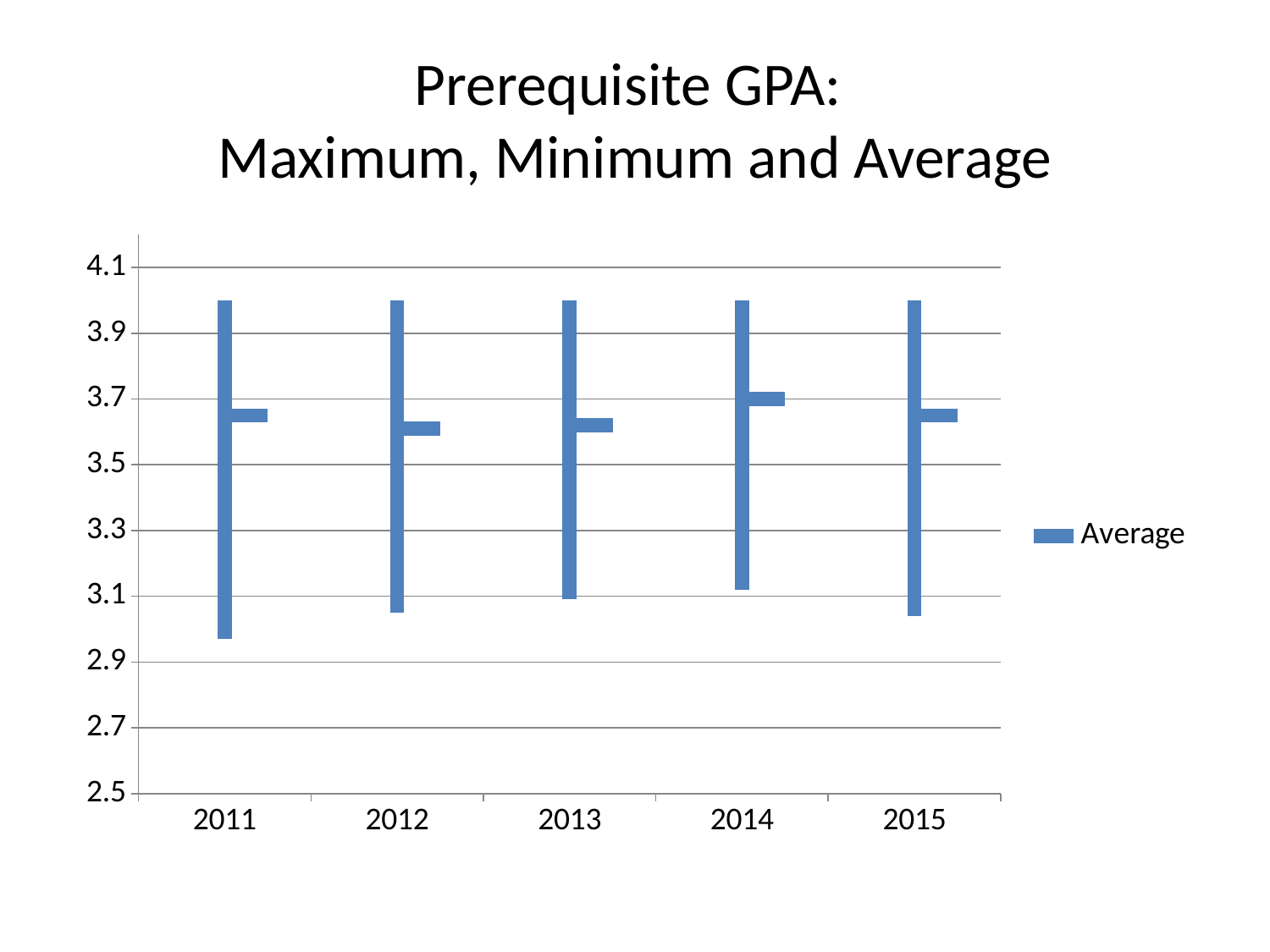
How many series does the chart legend list? 1 Is the average GPA for 2014 greater or less than 3.5? greater How many years are shown on the x axis of the chart? 5 Is the minimum GPA for 2015 greater or less than 3.3? less Which year has the higher average GPA, 2012 or 2014? 2014 What is the title of the chart? Prerequisite GPA: Maximum, Minimum and Average Which year has the lowest minimum GPA? 2011 Is the maximum GPA for 2013 greater or less than 3.9? greater What series name appears in the chart legend? Average Which year has the highest average GPA? 2014